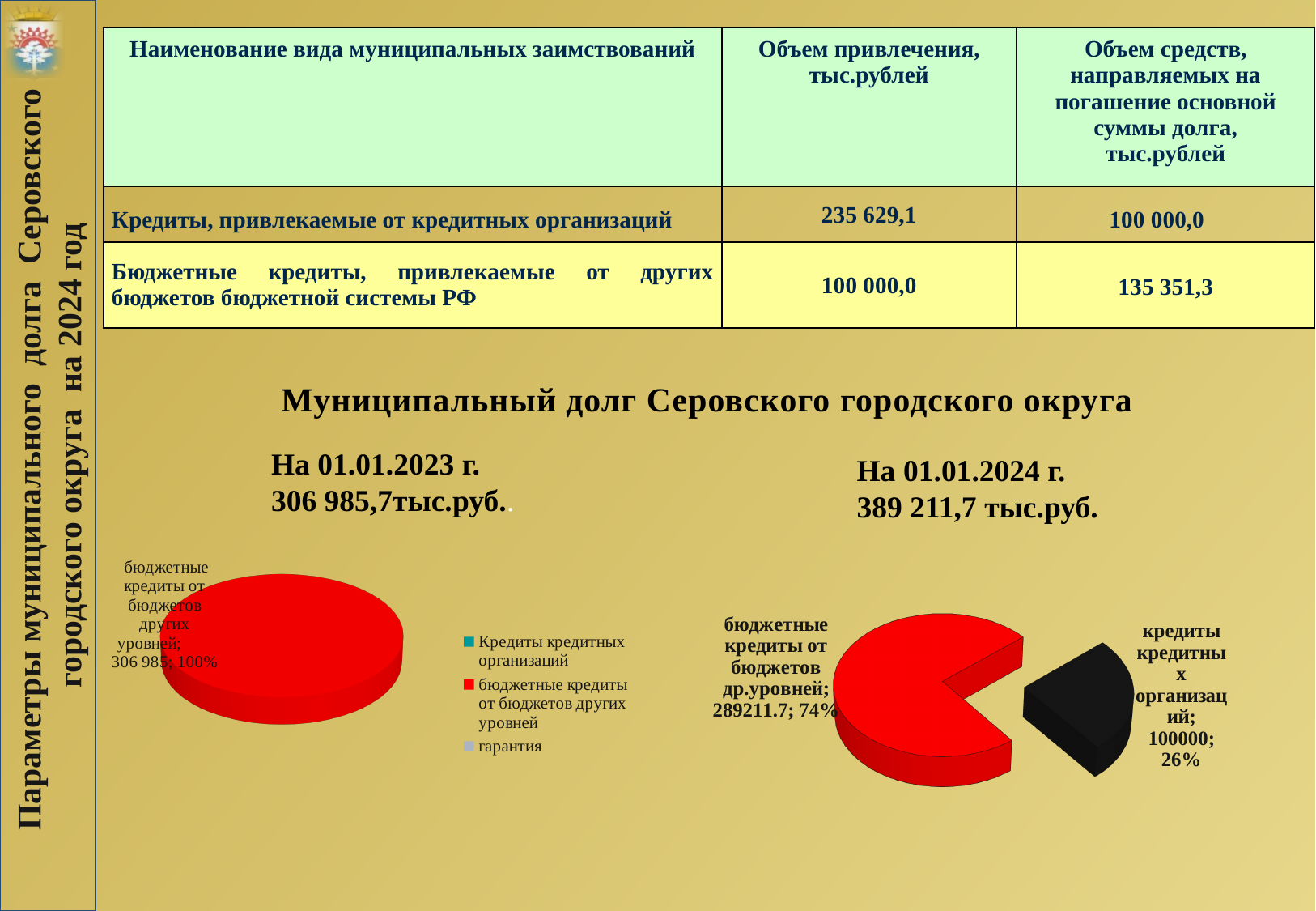
In the pie chart for 01.01.2024, what share of the pie is бюджетные кредиты от бюджетов др.уровней? 74% In the pie chart for 01.01.2024, how many slices are shown? 2 How many entries does the legend between the two pie charts list? 3 In the pie chart for 01.01.2024, what colour is the slice for кредиты кредитных организаций? black In the pie chart for 01.01.2024, which slice is the smallest? кредиты кредитных организаций In the pie chart for 01.01.2024, what is the value shown for кредиты кредитных организаций? 100000 In the pie chart for 01.01.2023, what share of the pie is бюджетные кредиты от бюджетов других уровней? 100% In the pie chart for 01.01.2024, which slice is the largest? бюджетные кредиты от бюджетов др.уровней What kind of chart is used to show the municipal debt as of 01.01.2024? pie chart In the pie chart for 01.01.2023, what value is shown for бюджетные кредиты от бюджетов других уровней? 306 985 In the pie chart for 01.01.2024, what is the value shown for бюджетные кредиты от бюджетов др.уровней? 289211.7 In the pie chart for 01.01.2024, what share of the pie is кредиты кредитных организаций? 26%